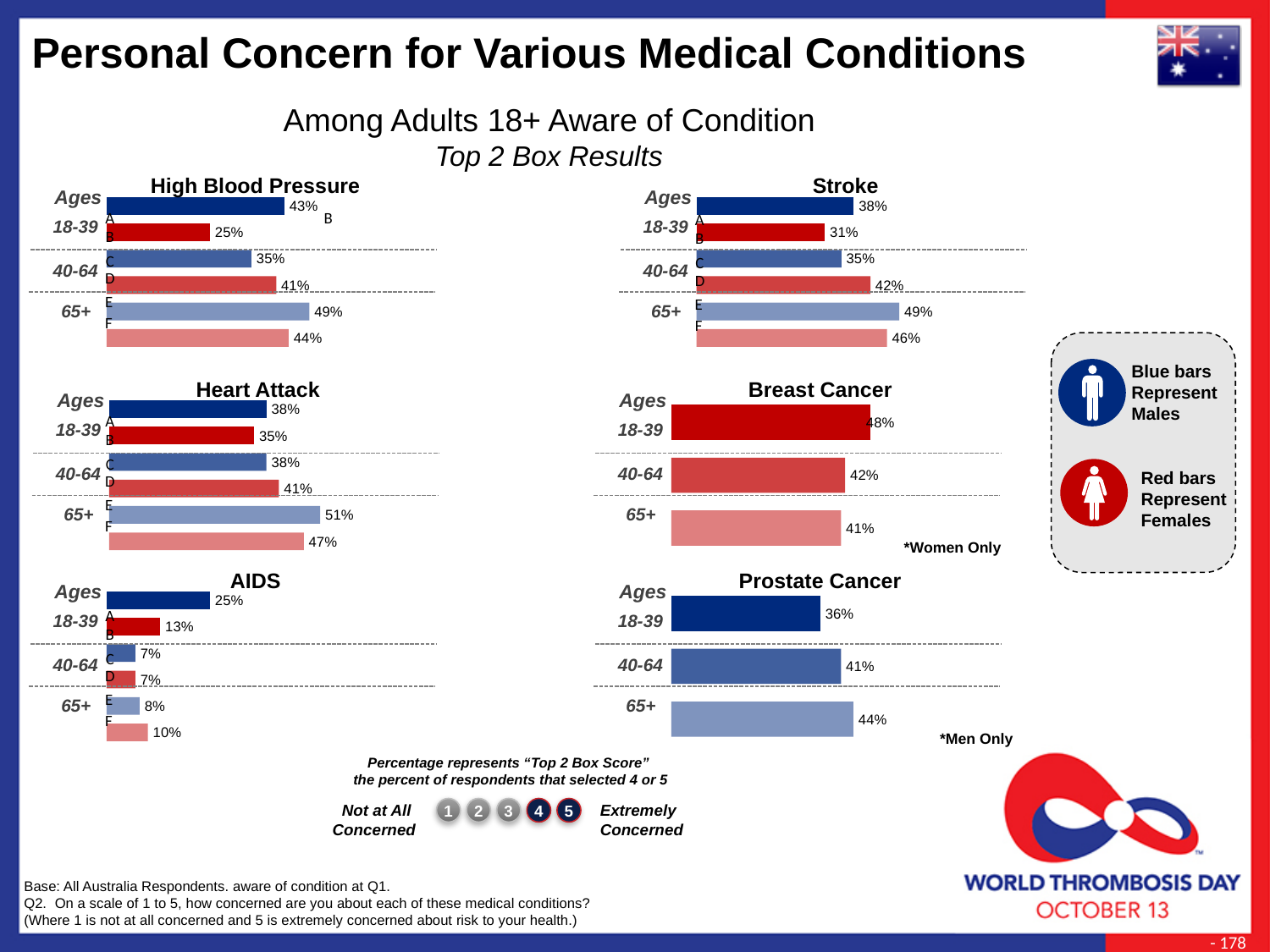
In the Prostate Cancer chart, do the values rise or fall as age increases from 18-39 to 65+? rise According to the legend on the slide, what do the red bars represent? Females How many age groups are shown in the Stroke chart? 3 In the High Blood Pressure chart, which is larger for ages 40-64: the male value or the female value? the female value In the Breast Cancer chart, which age group has the lowest value? 65+ In the Prostate Cancer chart, what is the difference between the 65+ value and the 18-39 value? 8% In the Heart Attack chart, which age group has the highest value for males? 65+ What type of chart is used for the Heart Attack data? bar chart In the AIDS chart, what is the value for females aged 18-39? 13% In the Breast Cancer chart, do the values rise or fall as age increases from 18-39 to 65+? fall In the Stroke chart, what is the value for females aged 40-64? 42% In the High Blood Pressure chart, what is the value for males aged 18-39? 43%